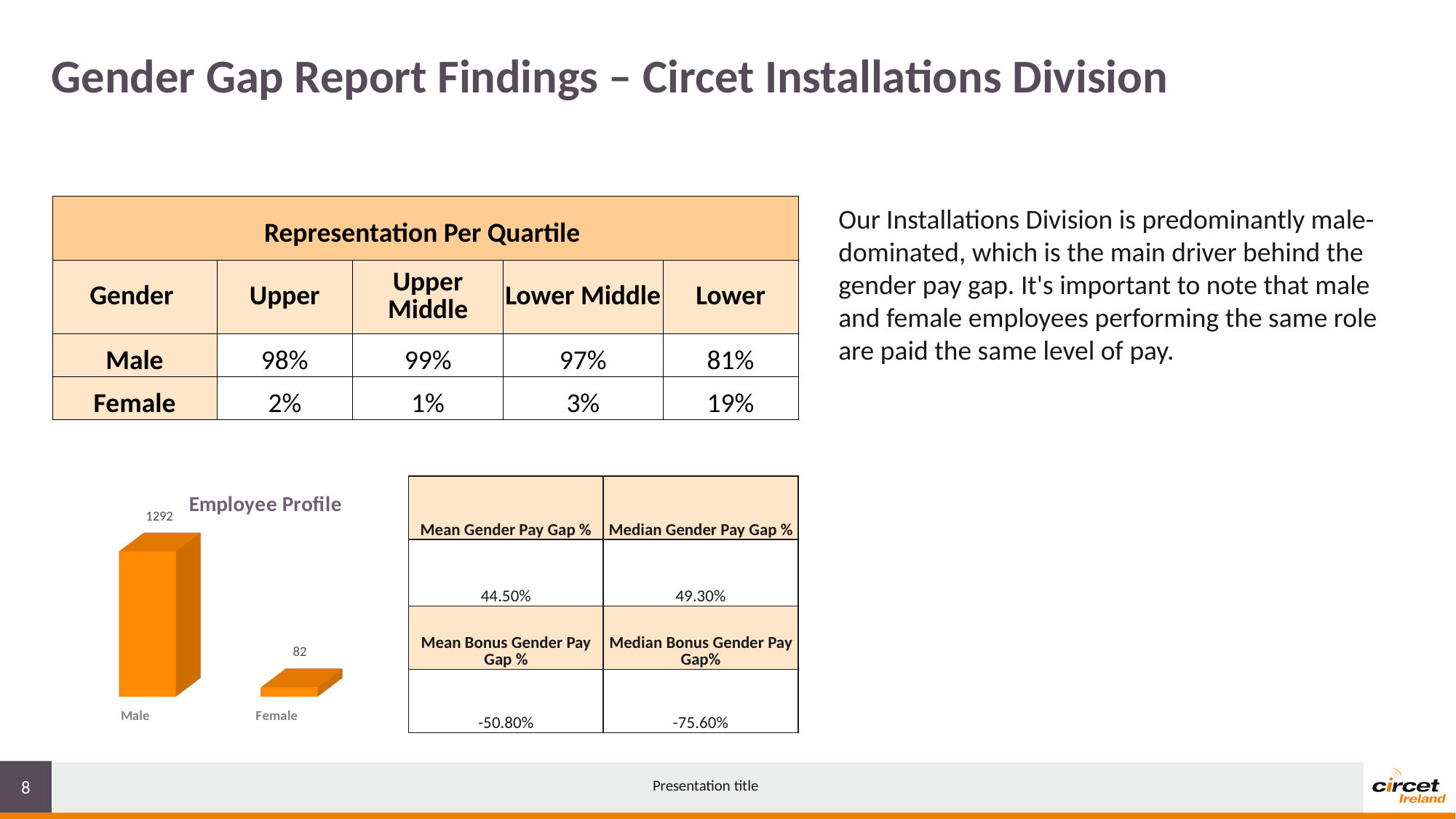
What colour are the bars in the Employee Profile chart? Orange In the Employee Profile chart, which category has the highest value? Male In the Employee Profile chart, which category has the lowest value? Female In the Employee Profile chart, what is the value for Female? 82 In the Employee Profile chart, which is larger, the value for Male or the value for Female? Male In the Employee Profile chart, do the values rise or fall from Male to Female? Fall In the Employee Profile chart, what is the value for Male? 1292 In the Employee Profile chart, what is the difference between the Male and Female values? 1210 How many categories are shown in the Employee Profile chart? 2 What kind of chart is the Employee Profile chart? Bar chart What is the title of the chart on the slide? Employee Profile